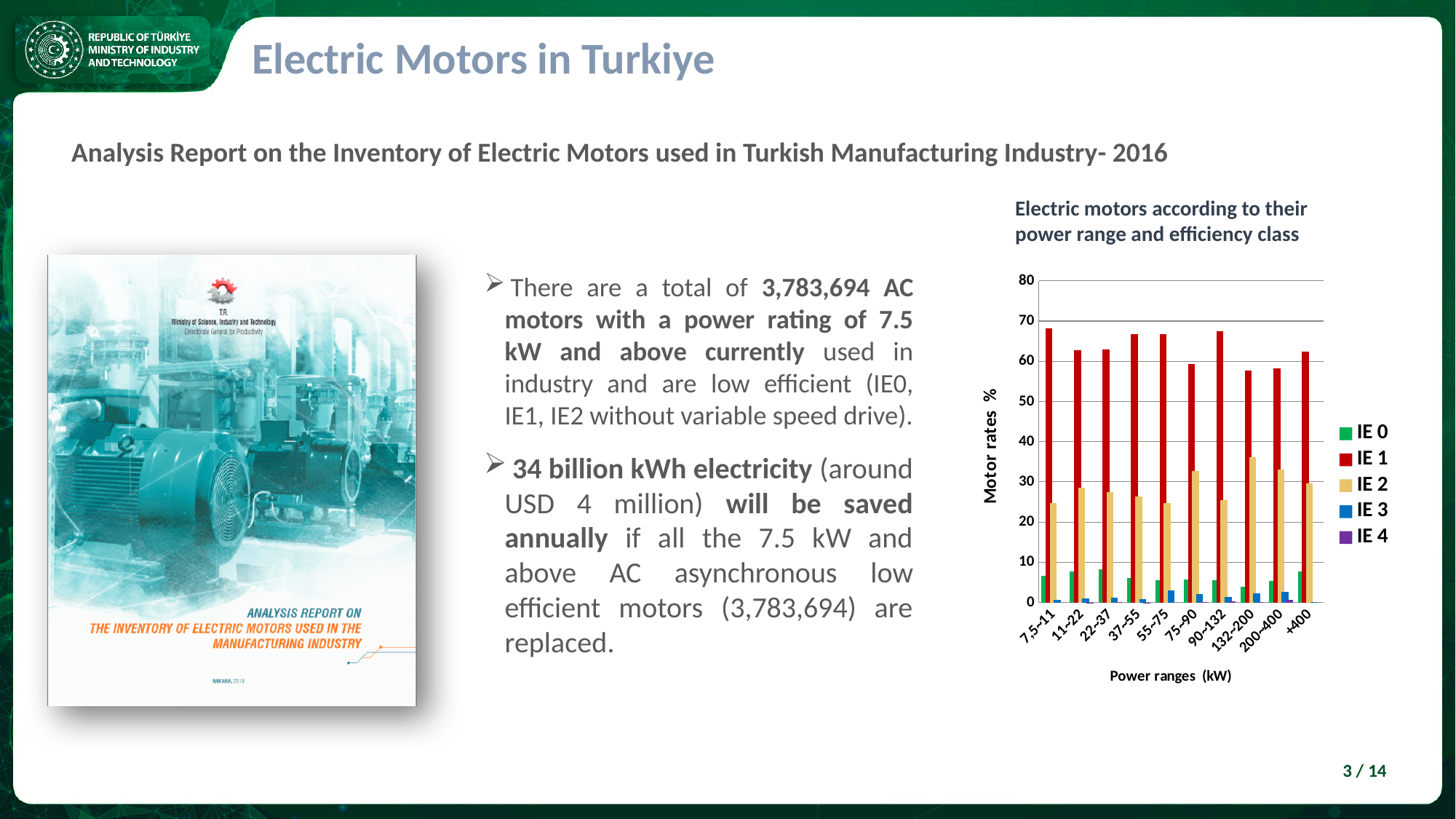
What kind of chart is shown under the title 'Electric motors according to their power range and efficiency class'? bar chart For the 7,5~11 kW power range, which is larger: the IE 1 value or the IE 2 value? IE 1 Is the IE 0 value for the 22~37 kW power range greater or less than 10? less What colour are the IE 1 bars in the chart? red Which efficiency class series has the highest bar in every power range category? IE 1 Which power range has the highest IE 2 value? 132~200 Is the IE 2 value for the 132~200 kW power range greater or less than 30? greater How many power range categories are shown on the x axis of the chart? 10 How many series does the legend of the chart list? 5 Is the IE 1 value for the 132~200 kW power range greater or less than 60? less What is the label of the y axis of the chart? Motor rates %